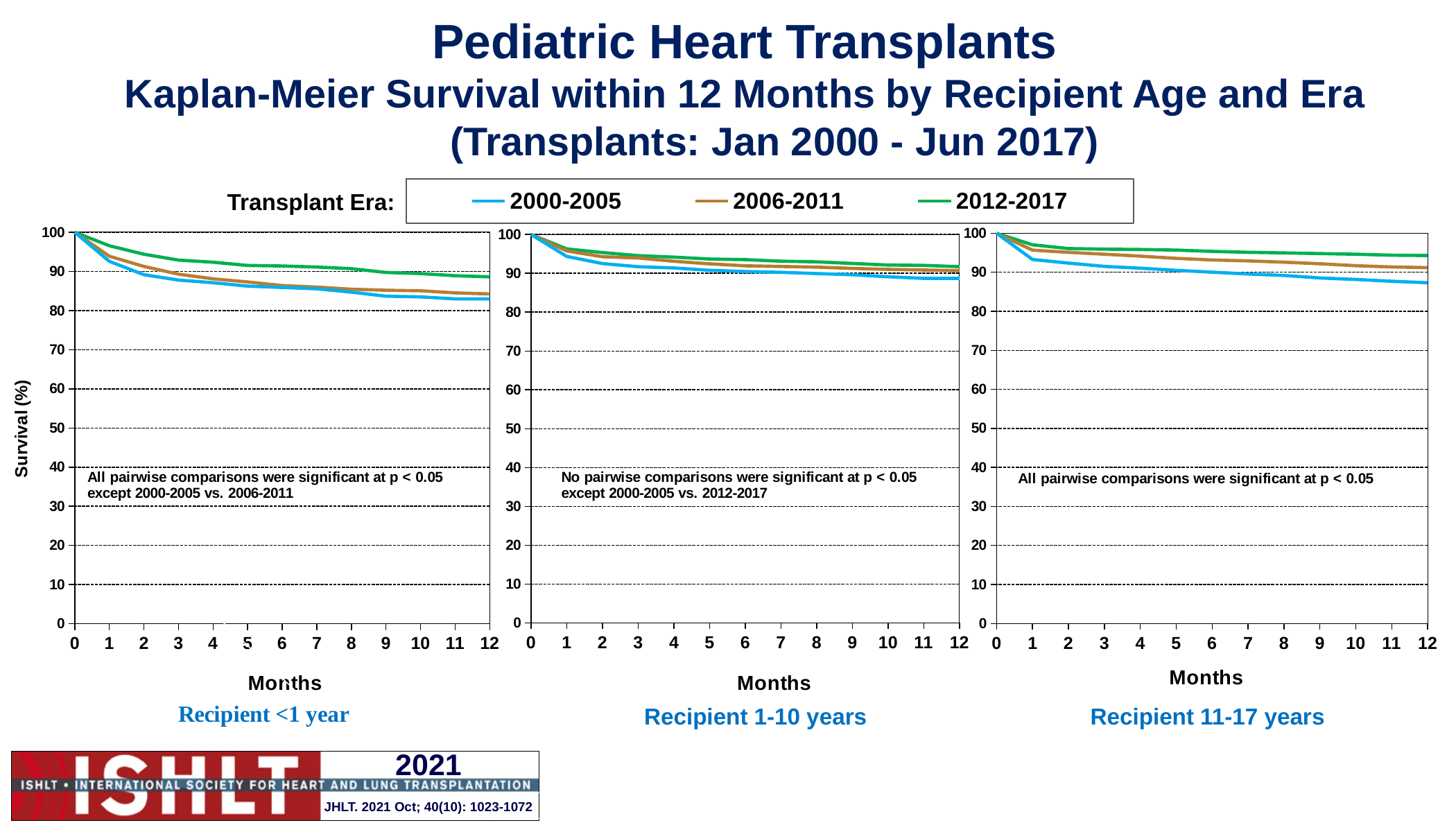
What is the label of the y axis on the left-hand chart? Survival (%) Which colour represents the 2006-2011 transplant era in the legend? brown What kind of chart is used for the 'Recipient <1 year' panel? line chart In the 'Recipient 1-10 years' chart, is the 12-month survival for the 2012-2017 era greater or less than 90? greater In the 'Recipient 11-17 years' chart, is the 12-month survival for the 2000-2005 era greater or less than 90? less In the 'Recipient <1 year' chart, which transplant era has the lowest survival at 12 months? 2000-2005 In the 'Recipient 11-17 years' chart, which transplant era has the highest survival at 12 months? 2012-2017 How many transplant eras does the legend list? 3 In the 'Recipient <1 year' chart, is the 12-month survival for the 2000-2005 era greater or less than 90? less In the 'Recipient <1 year' chart, what is the survival value for the 2012-2017 era at month 0? 100 In the 'Recipient 11-17 years' chart, which era has higher survival at 6 months: 2006-2011 or 2000-2005? 2006-2011 In the 'Recipient 1-10 years' chart, do the survival curves rise or fall as months increase? fall